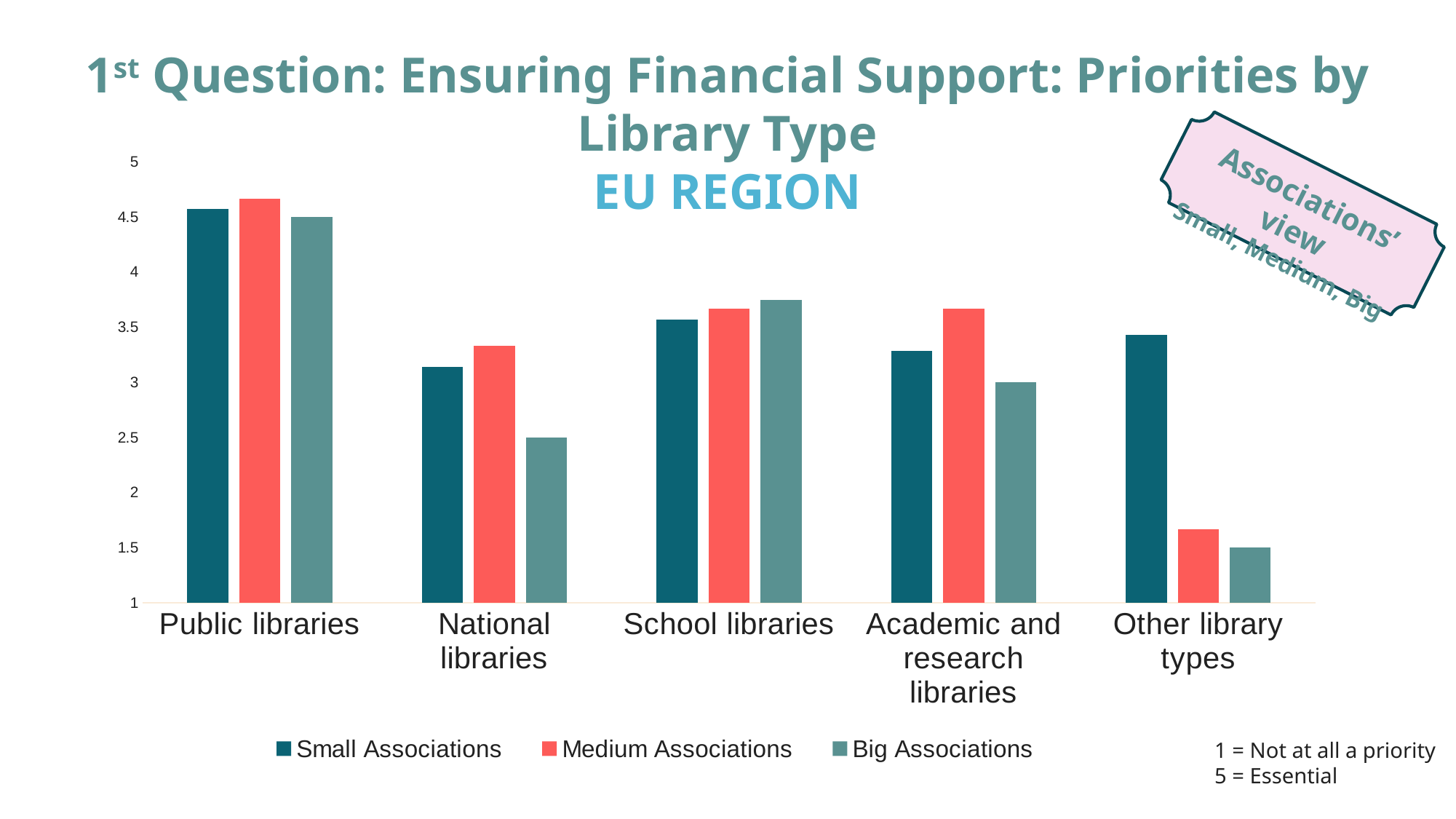
How many library type categories are shown on the x axis? 5 For Academic and research libraries, which series has the highest value? Medium Associations Is the value for Small Associations for Other library types greater or less than 3? greater Which region does the chart subtitle say the data covers? EU REGION For National libraries, which is larger: the value for Small Associations or for Big Associations? Small Associations Is the value for Medium Associations for Other library types greater or less than 2? less What type of chart is shown on the slide? Bar chart For Medium Associations, which library type has the lowest value? Other library types For Small Associations, which library type has the highest value? Public libraries How many series does the legend list? 3 What is the value for Big Associations for National libraries? 2.5 Is the value for Big Associations for School libraries greater or less than 3.5? greater